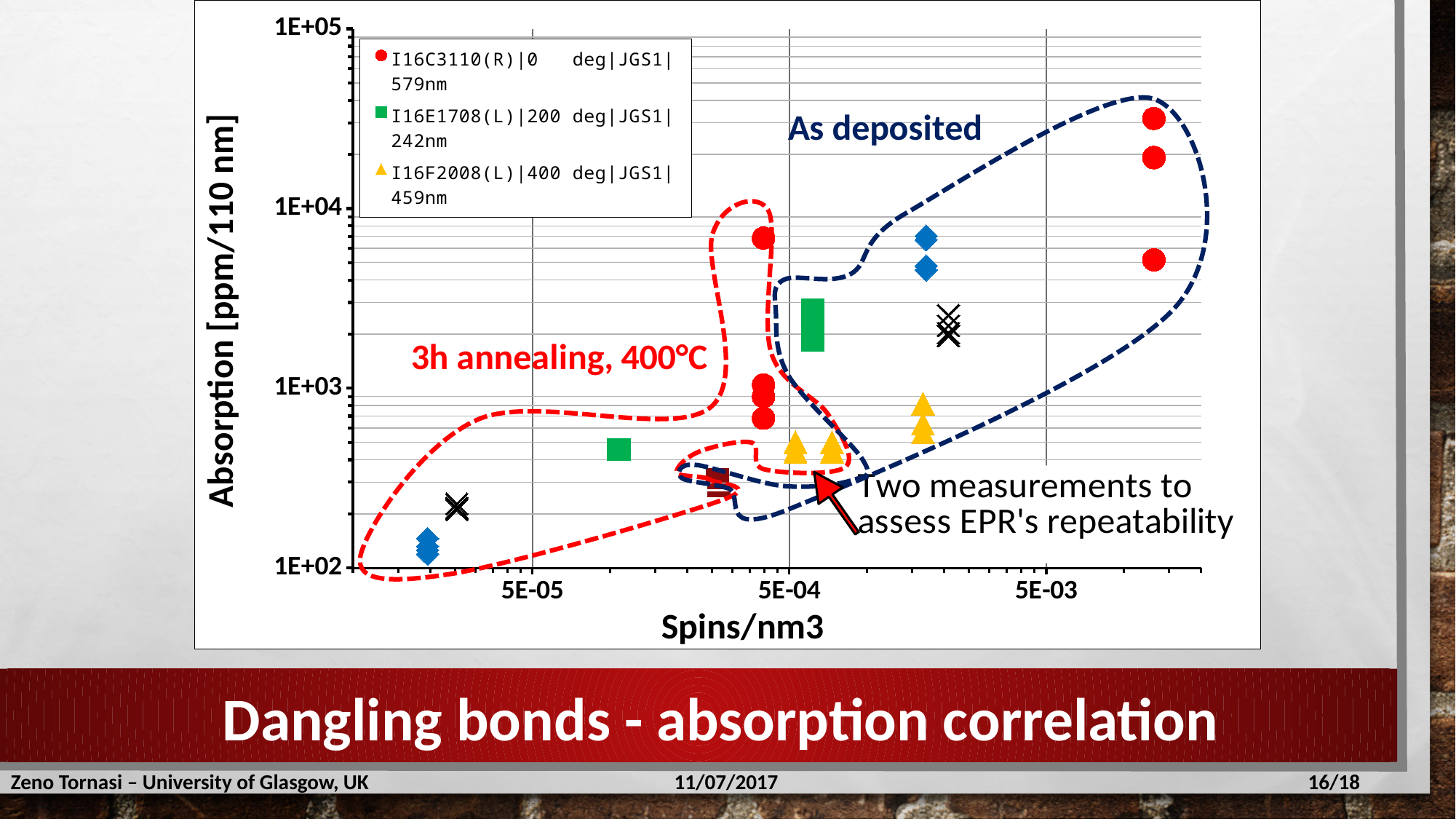
What kind of chart is shown on the slide? scatter chart Is the lowest absorption value of the I16C3110(R)|0 deg|JGS1|579nm series greater or less than 1E+02? greater How many series does the chart's legend list? 3 Is the highest absorption value of the I16C3110(R)|0 deg|JGS1|579nm series greater or less than 1E+04? greater Which legend series reaches the highest absorption value on the chart? I16C3110(R)|0 deg|JGS1|579nm What is the title of the x axis of the chart? Spins/nm3 Is the absorption value of the I16E1708(L)|200 deg|JGS1|242nm point located left of 5E-04 spins/nm3 greater or less than 1E+03? less Does absorption generally rise or fall as spins/nm3 increases along the x axis? rise What label is written next to the red dashed outline on the chart? 3h annealing, 400°C Which series has the higher maximum absorption: I16E1708(L)|200 deg|JGS1|242nm or I16F2008(L)|400 deg|JGS1|459nm? I16E1708(L)|200 deg|JGS1|242nm